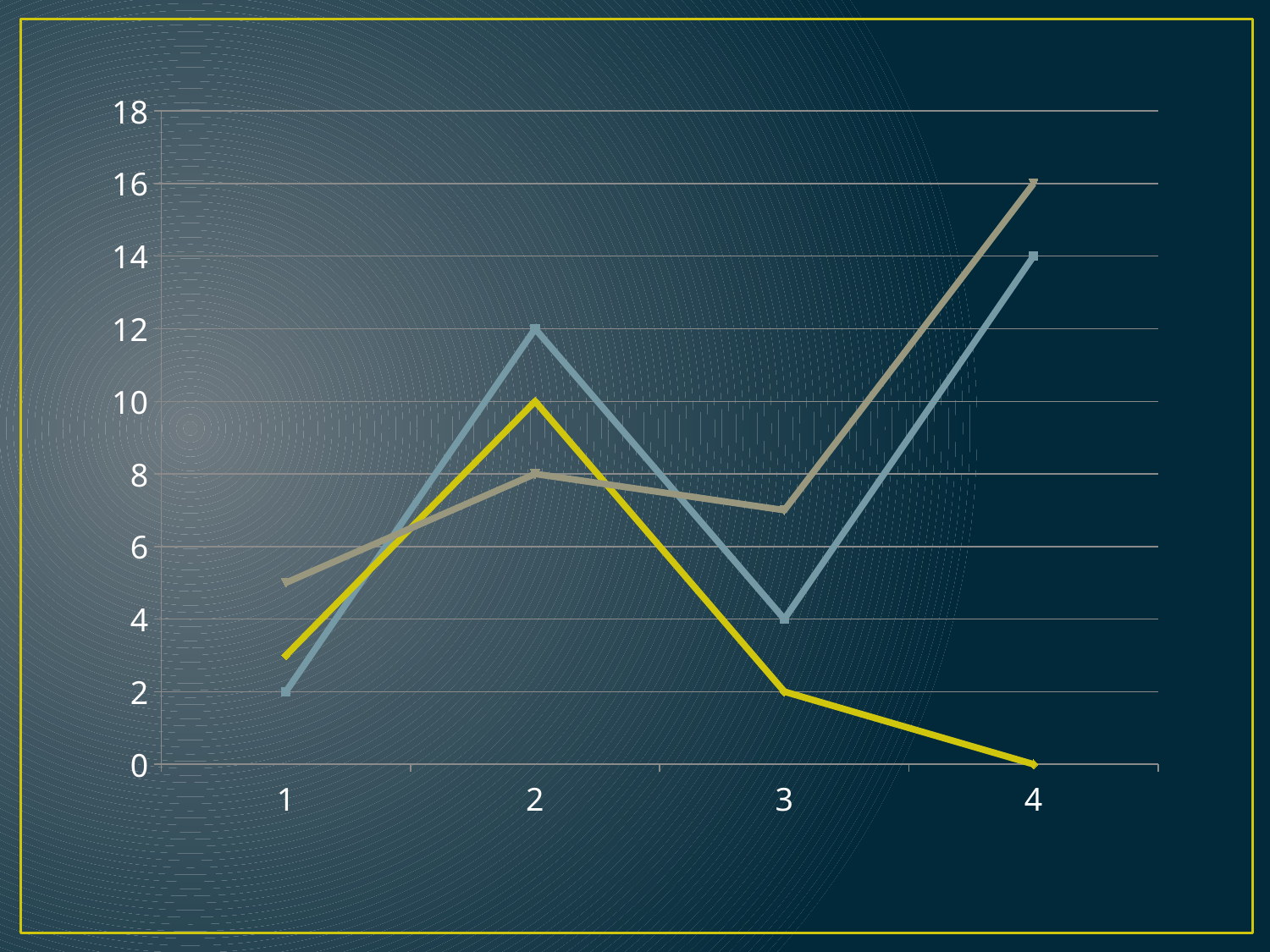
At which x value does the yellow line reach its highest point? 2 Which line has the highest value at x = 4? The tan line What is the value of the yellow line at x = 2? 10 What is the value of the tan line at x = 4? 16 How many points are on the x axis of the chart? 4 Is the value of the tan line at x = 1 greater or less than 6? less How many lines are plotted on the chart? 3 What is the value of the yellow line at x = 4? 0 What is the difference between the light blue line and the tan line at x = 2? 4 What is the value of the light blue line at x = 4? 14 What kind of chart is shown on the slide? Line chart What is the value of the light blue line at x = 2? 12